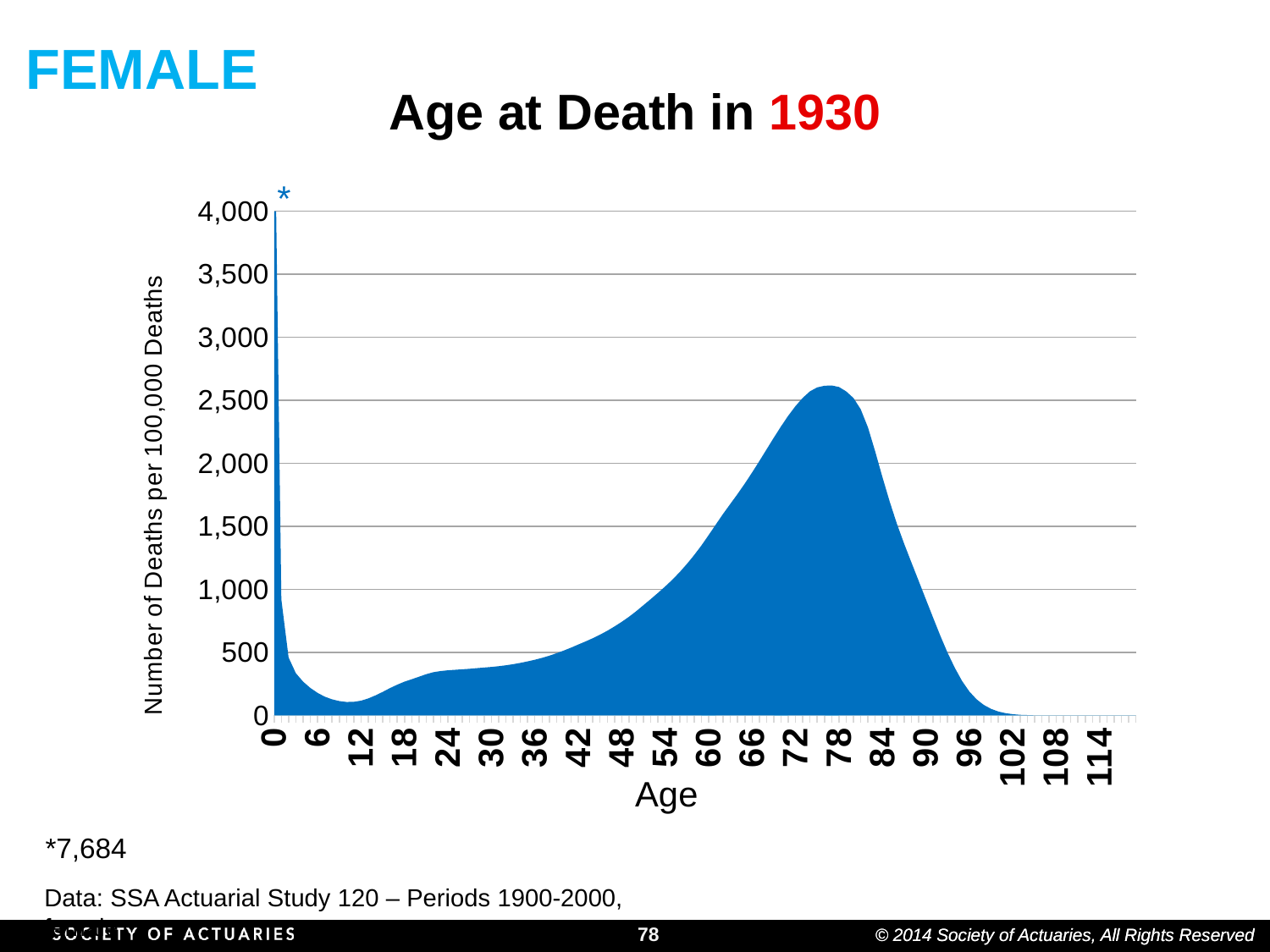
What is the number of deaths per 100,000 deaths at age 0, as given by the asterisk footnote? 7,684 Do the values rise or fall as age increases from 48 to 72? rise Which age has the larger value, age 12 or age 72? 72 What is the label of the vertical axis? Number of Deaths per 100,000 Deaths Is the value at age 60 greater or less than 1,000? greater Do the values rise or fall as age increases from 78 to 102? fall At which age is the number of deaths per 100,000 deaths highest? 0 Is the value at age 24 greater or less than 500? less Is the value at age 72 greater or less than 2,000? greater What kind of chart is shown on the slide? area chart